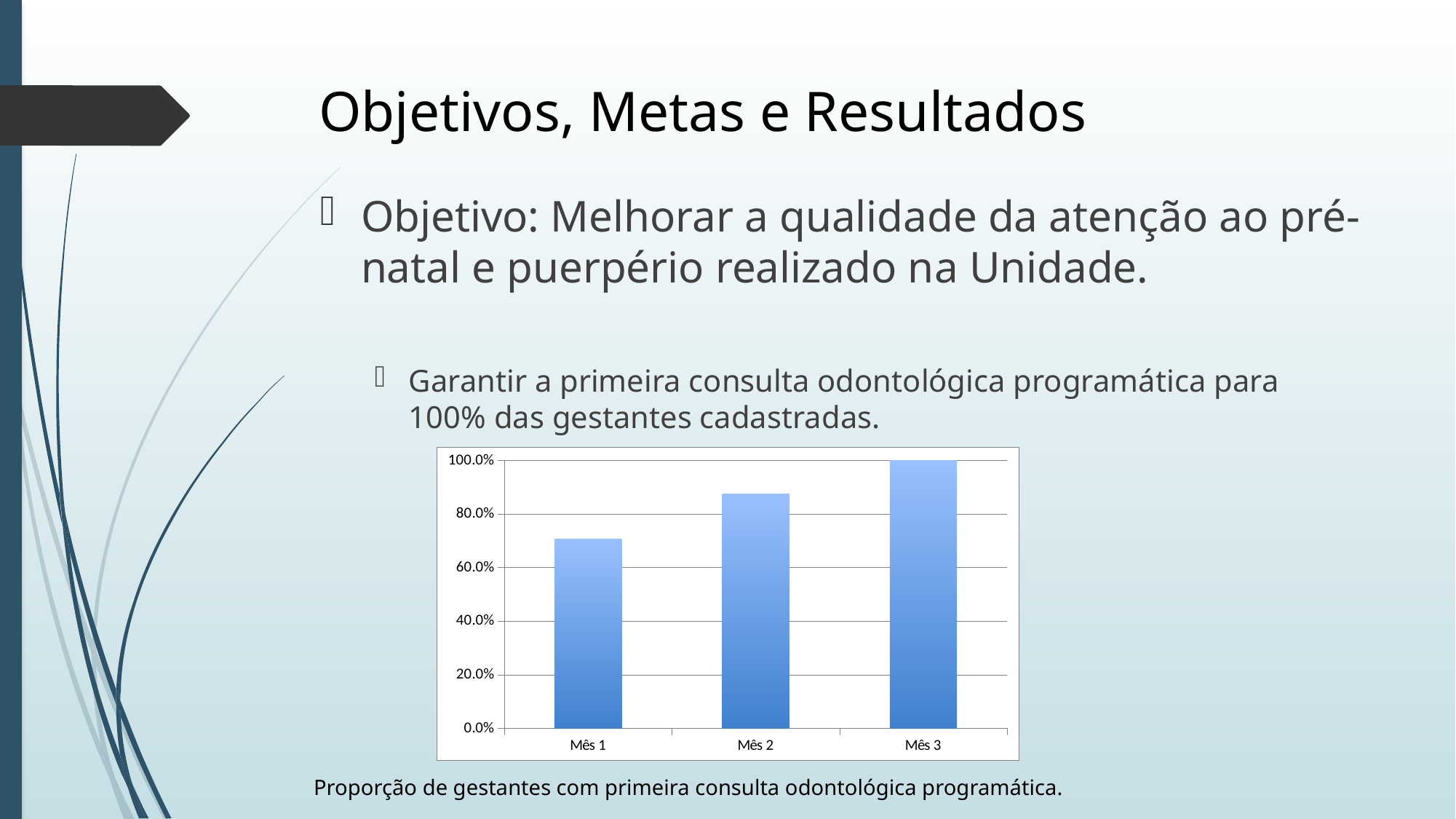
How many categories are shown on the x axis of the chart? 3 Is the value for Mês 1 greater or less than 80.0%? less Do the values rise or fall from Mês 1 to Mês 3? rise What is the value for Mês 3 in the chart? 100.0% Is the value for Mês 2 greater or less than 80.0%? greater What is the highest tick value shown on the y axis of the chart? 100.0% Which month has the lowest value in the chart? Mês 1 What caption is written below the chart? Proporção de gestantes com primeira consulta odontológica programática. What kind of chart is shown on the slide? bar chart Which is larger, the value for Mês 1 or the value for Mês 2? Mês 2 Is the value for Mês 1 greater or less than 60.0%? greater Which month has the highest value in the chart? Mês 3